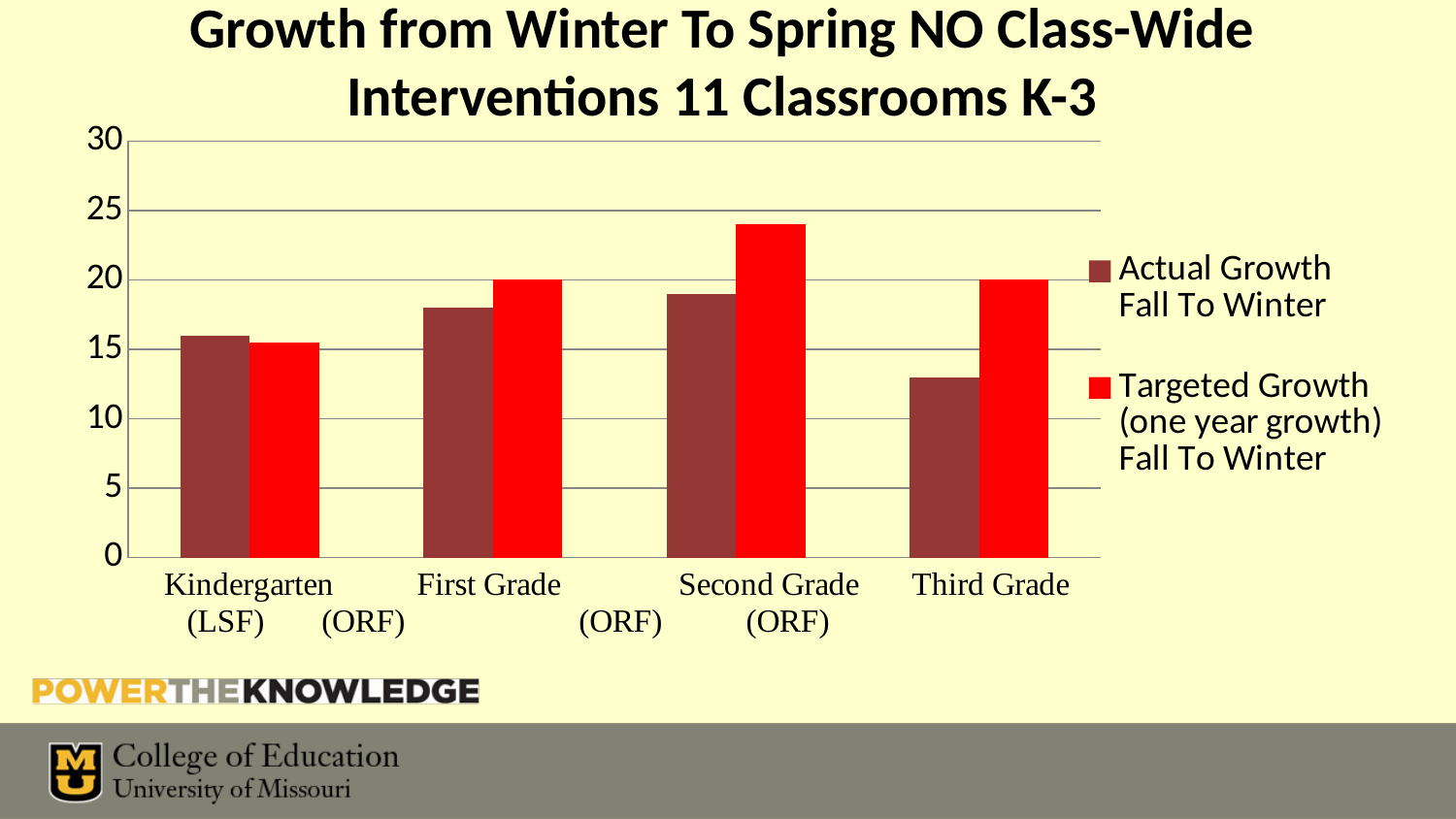
What kind of chart is shown on the slide? bar chart Is the Actual Growth value for First Grade greater or less than 20? less Is the Targeted Growth value for Second Grade greater or less than 20? greater For Second Grade, which is larger: Actual Growth or Targeted Growth? Targeted Growth Which grade has the lowest Actual Growth Fall To Winter? Third Grade For Third Grade, which is larger: Actual Growth or Targeted Growth? Targeted Growth What colour are the Targeted Growth bars? red What is the Targeted Growth (one year growth) Fall To Winter value for First Grade? 20 How many series does the legend list? 2 Is the Actual Growth value for Third Grade greater or less than 15? less How many grade-level categories are shown on the x axis? 4 Which grade has the highest Targeted Growth (one year growth) Fall To Winter? Second Grade